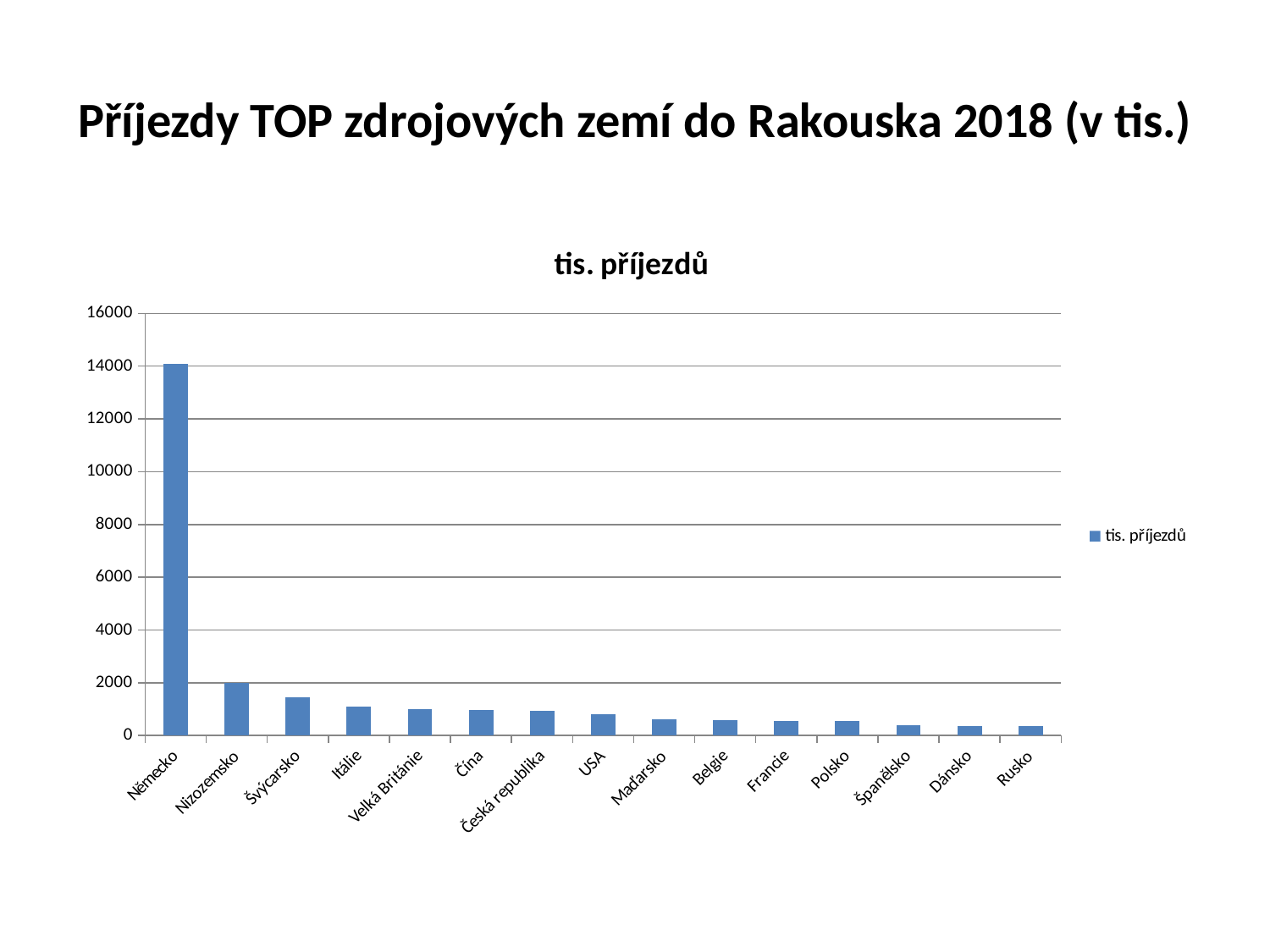
Which has a larger value, Nizozemsko or Švýcarsko? Nizozemsko Which country has the highest value in the chart? Německo Is the value for Nizozemsko greater or less than 4000? less Is the value for Švýcarsko greater or less than 2000? less What kind of chart is shown on the slide? bar chart Is the value for Německo greater or less than 12000? greater Which has a larger value, Německo or Nizozemsko? Německo What is the title of the chart? tis. příjezdů How many series does the legend list? 1 How many countries are shown on the x axis of the chart? 15 Do the values generally rise or fall from left to right along the x axis? fall